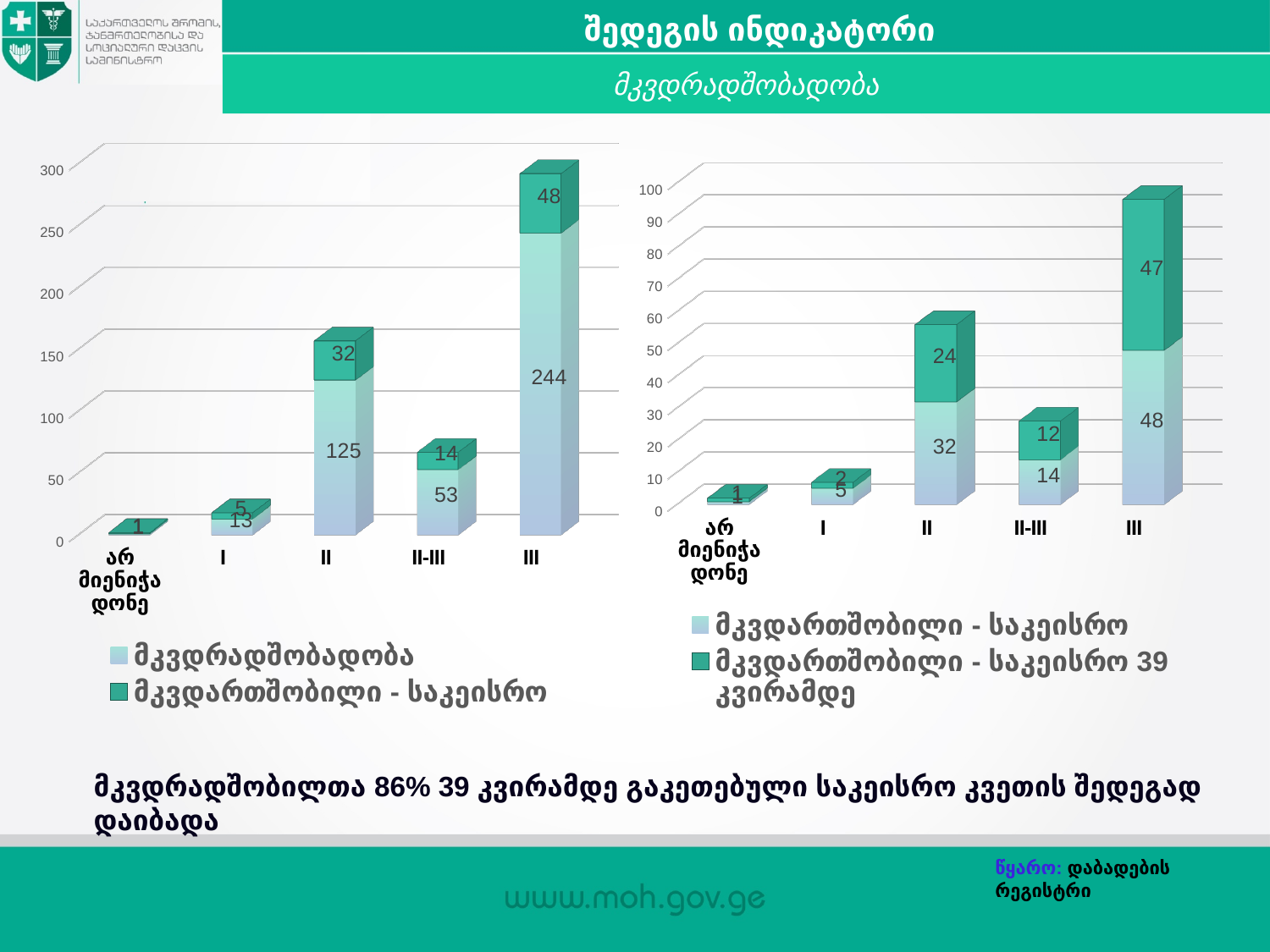
On the right chart, what is the total of the stacked bar for category II-III? 26 What type of chart is the left chart? Stacked bar chart On the right chart, which is larger for category II: მკვდარშობილი - საკეისრო or მკვდარშობილი - საკეისრო 39 კვირამდე? მკვდარშობილი - საკეისრო How many series does the legend of the right chart list? 2 On the left chart, what is the value of მკვდრადშობადობა for category III? 244 On the left chart, what is the difference between the მკვდრადშობადობა values for III and II? 119 On the left chart, which category has the highest მკვდრადშობადობა value? III On the left chart, what is the total of the stacked bar for category II? 157 On the right chart, what is the value of მკვდარშობილი - საკეისრო for category II? 32 On the left chart, what is the value of მკვდრადშობადობა for category II-III? 53 On the left chart, what is the value of მკვდარშობილი - საკეისრო for category II? 32 On the right chart, what is the value of მკვდარშობილი - საკეისრო 39 კვირამდე for category III? 47